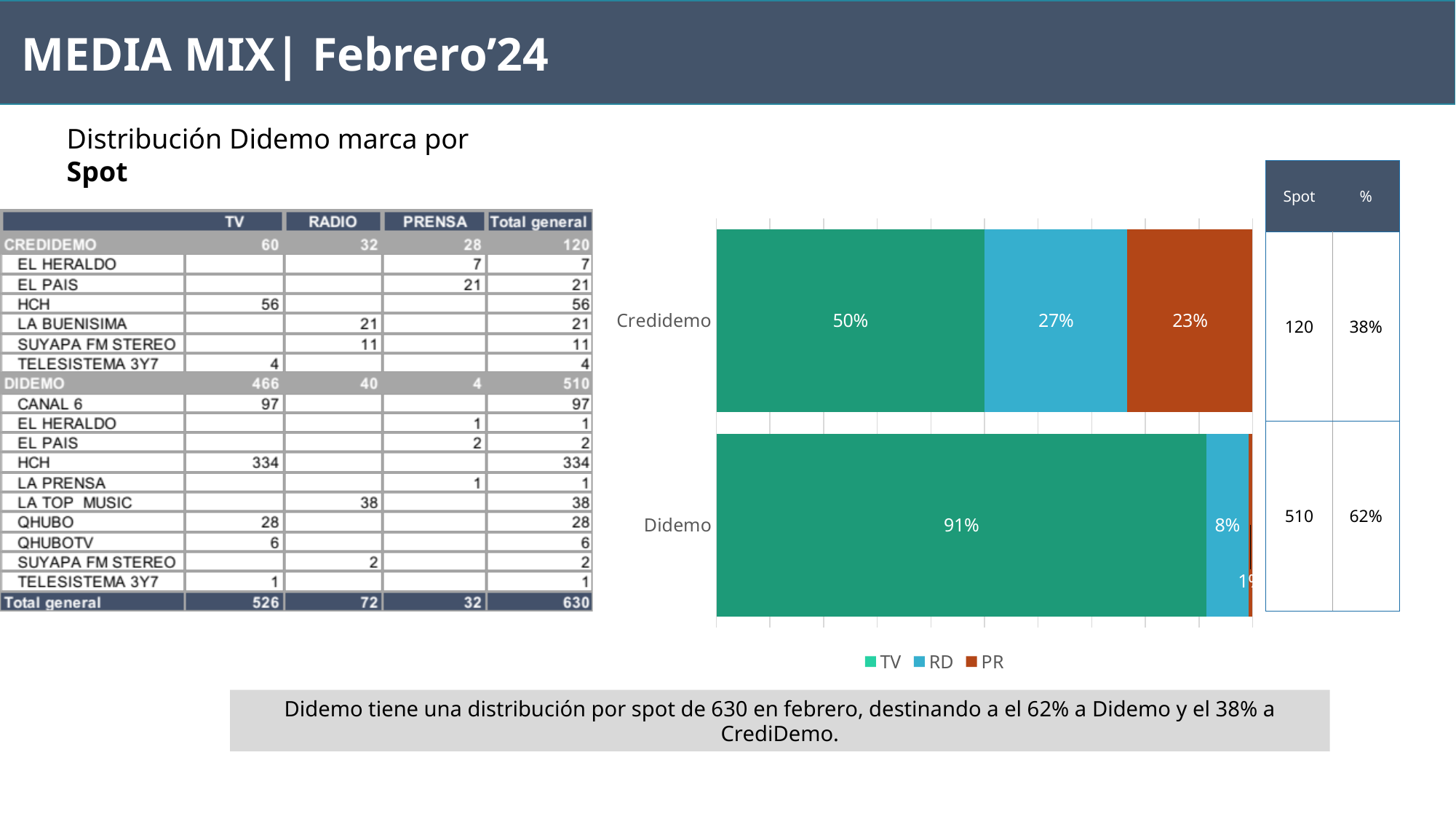
What is the RD share for Credidemo in the chart? 27% What is the PR share for Credidemo in the chart? 23% What kind of chart is shown on the slide? stacked bar chart How many categories are plotted in the chart? 2 What is the TV share for Credidemo in the chart? 50% Which series is shown in orange in the chart legend? PR Which category has the larger TV share, Credidemo or Didemo? Didemo Which series has the smallest share for Credidemo? PR What is the TV share for Didemo in the chart? 91% What is the difference between the TV share of Didemo and the TV share of Credidemo? 41% What is the RD share for Didemo in the chart? 8% How many series does the chart legend list? 3